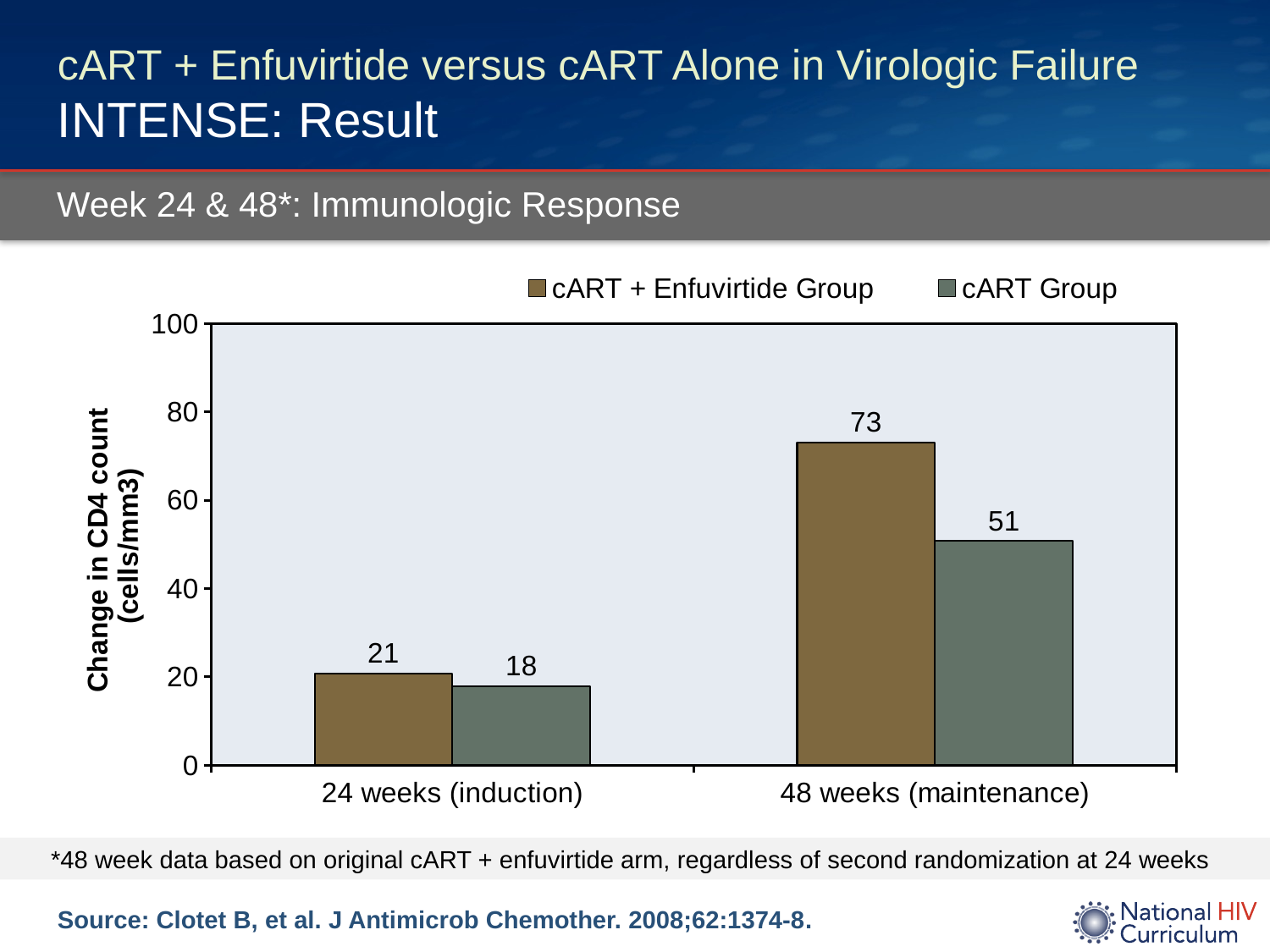
What is the change in CD4 count for the cART + Enfuvirtide Group at 24 weeks (induction)? 21 What is the change in CD4 count for the cART + Enfuvirtide Group at 48 weeks (maintenance)? 73 What kind of chart is shown on the slide? Bar chart What is the change in CD4 count for the cART Group at 24 weeks (induction)? 18 What is the difference in change in CD4 count between the cART + Enfuvirtide Group and the cART Group at 48 weeks (maintenance)? 22 At 24 weeks (induction), which group has the larger change in CD4 count? cART + Enfuvirtide Group Which bar shows the highest change in CD4 count? cART + Enfuvirtide Group at 48 weeks (maintenance) How many series does the legend list? 2 Which bar shows the lowest change in CD4 count? cART Group at 24 weeks (induction) Is the value for the cART Group at 48 weeks (maintenance) greater or less than 40? greater What is the label of the y axis? Change in CD4 count (cells/mm3) What is the change in CD4 count for the cART Group at 48 weeks (maintenance)? 51